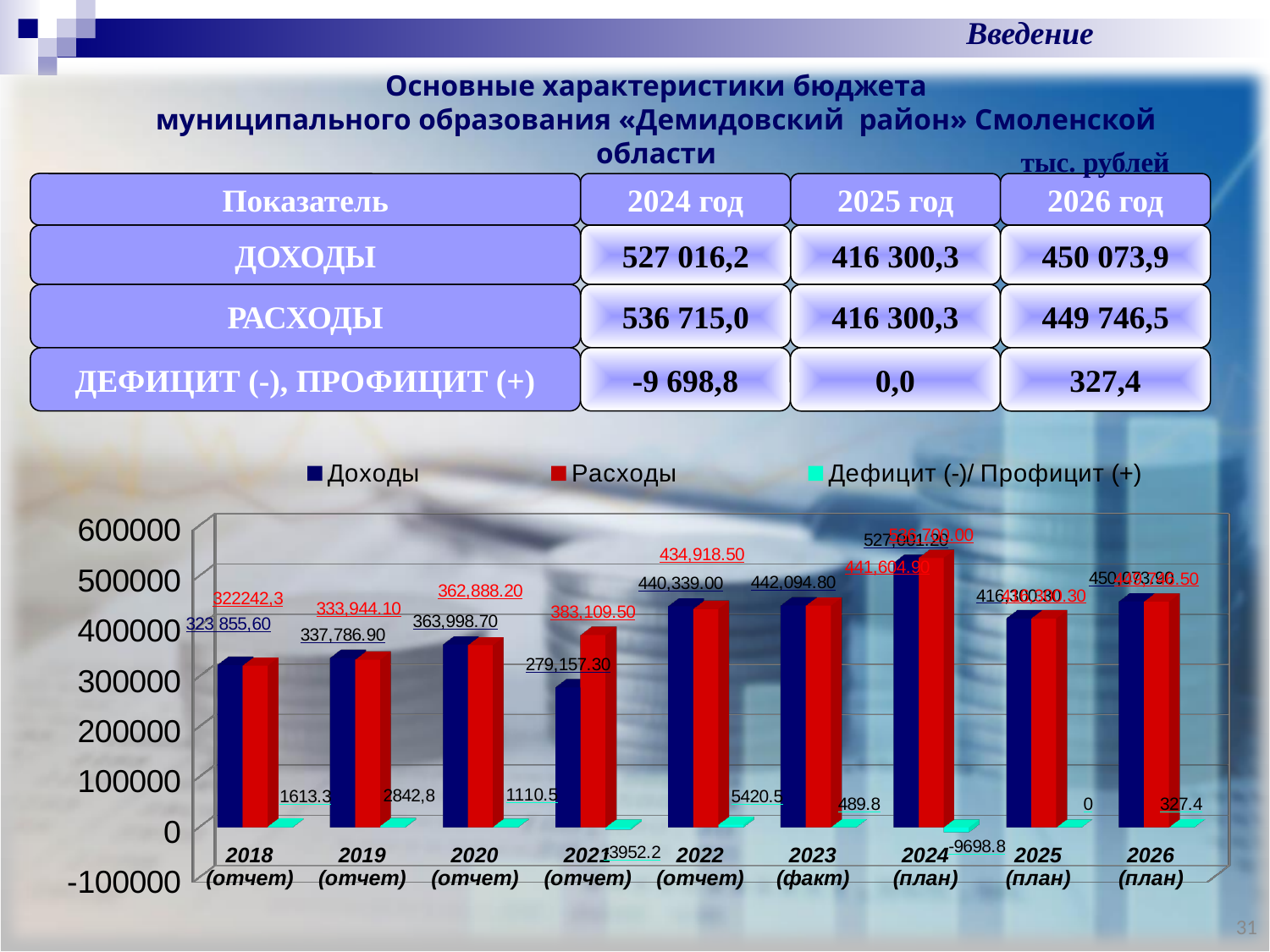
In which year is Доходы the highest in the chart? 2024 (план) What is the value of Доходы for 2022 (отчет) in the chart? 440,339.00 How many year categories are shown on the x axis of the chart? 9 What is the value of Доходы for 2020 (отчет) in the chart? 363,998.70 For 2021 (отчет), which is larger in the chart: Доходы or Расходы? Расходы Which colour represents Расходы in the chart legend? red In which year is Доходы the lowest in the chart? 2021 (отчет) What is the value of Дефицит (-)/ Профицит (+) for 2023 (факт) in the chart? 489.8 What is the difference between Доходы and Расходы for 2022 (отчет) in the chart? 5,420.50 How many series does the chart legend list? 3 What type of chart is shown on the slide? bar chart What is the value of Расходы for 2021 (отчет) in the chart? 383,109.50